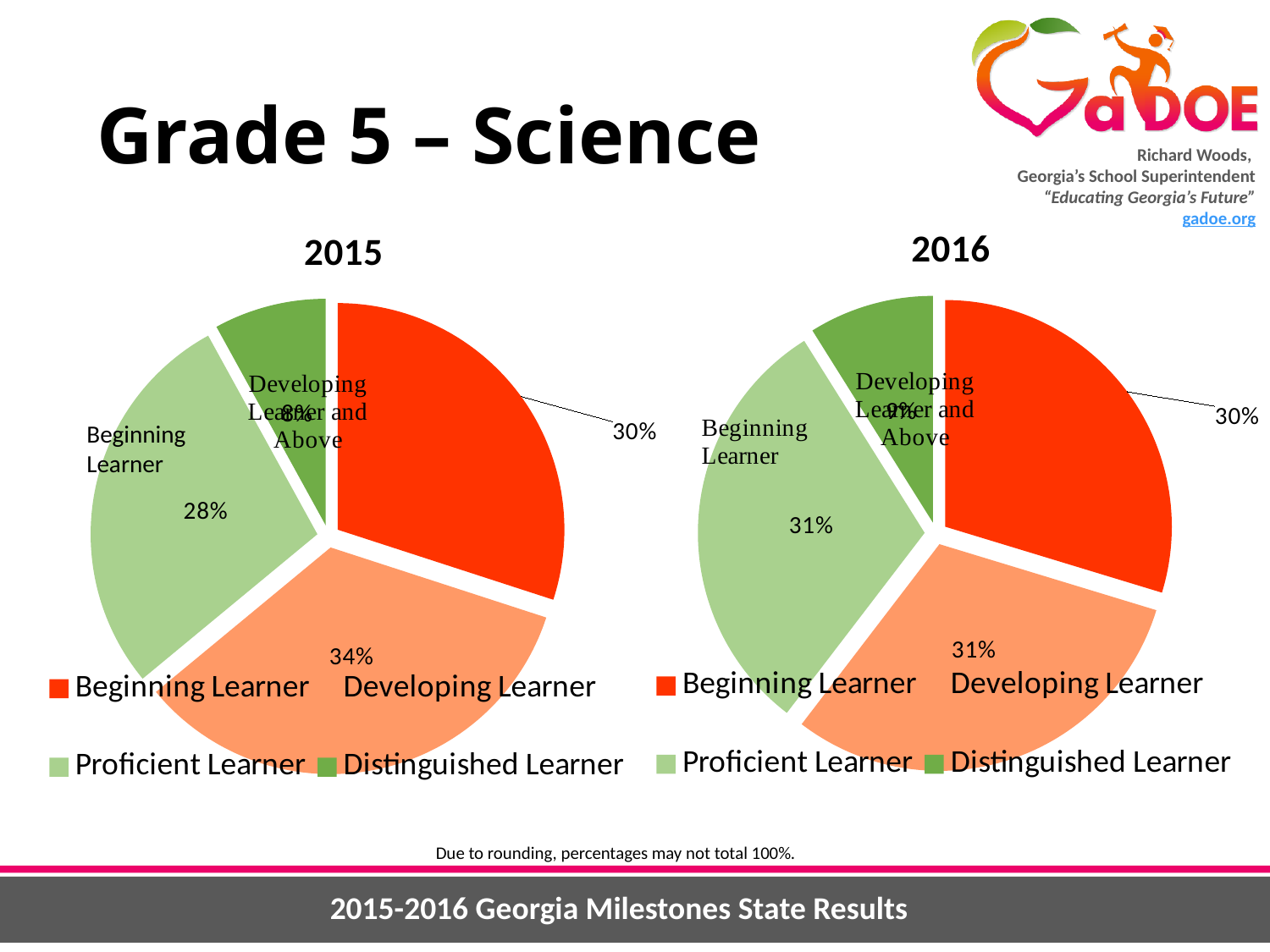
How many categories does the legend of the 2016 chart list? 4 In the 2015 chart, which category has the largest slice? Developing Learner In the 2016 chart, which category has the smallest slice? Distinguished Learner In the 2015 chart, which category has the smallest slice? Distinguished Learner In the 2015 chart, which is larger: Developing Learner or Proficient Learner? Developing Learner In the 2015 chart, what is the difference between the Developing Learner and Proficient Learner percentages? 6 percentage points In the 2015 chart, what percentage is shown for Proficient Learner? 28% How many slices does the 2016 pie chart have? 4 In the 2016 chart, what percentage is shown for Beginning Learner? 30% What kind of chart is the 2015 chart? pie chart In the 2015 chart, what percentage is shown for Beginning Learner? 30% In the 2015 chart, what percentage is shown for Developing Learner? 34%